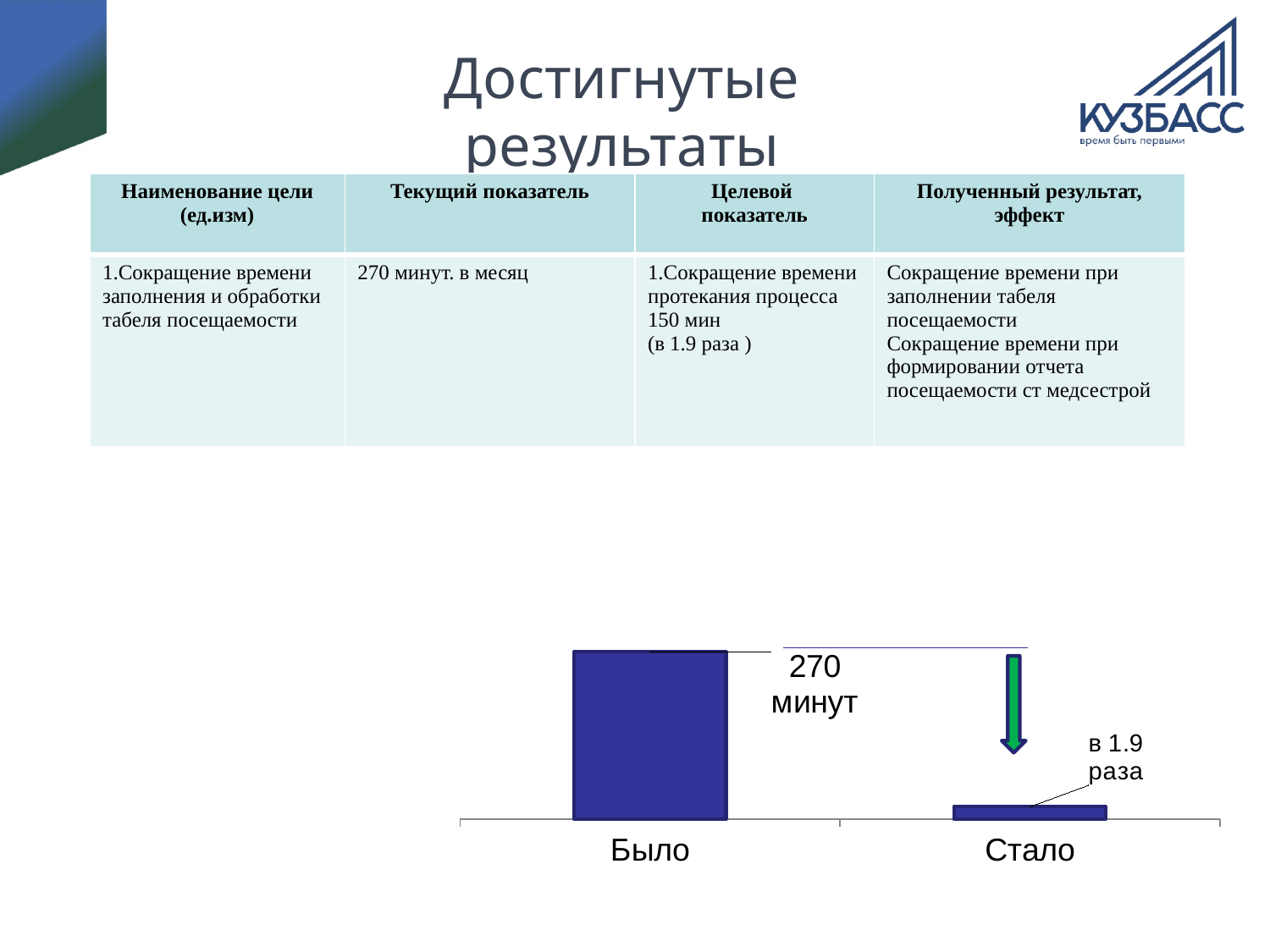
Which category has the shortest bar? Стало What are the two category labels on the x axis of the chart? Было, Стало Which category has the tallest bar? Было Which bar is taller, "Было" or "Стало"? Было What annotation is attached to the "Стало" bar? в 1.9 раза Do the bar values rise or fall from "Было" to "Стало"? fall What value is labelled on the "Было" bar? 270 минут How many bars does the chart have? 2 What kind of chart is shown on the slide? bar chart